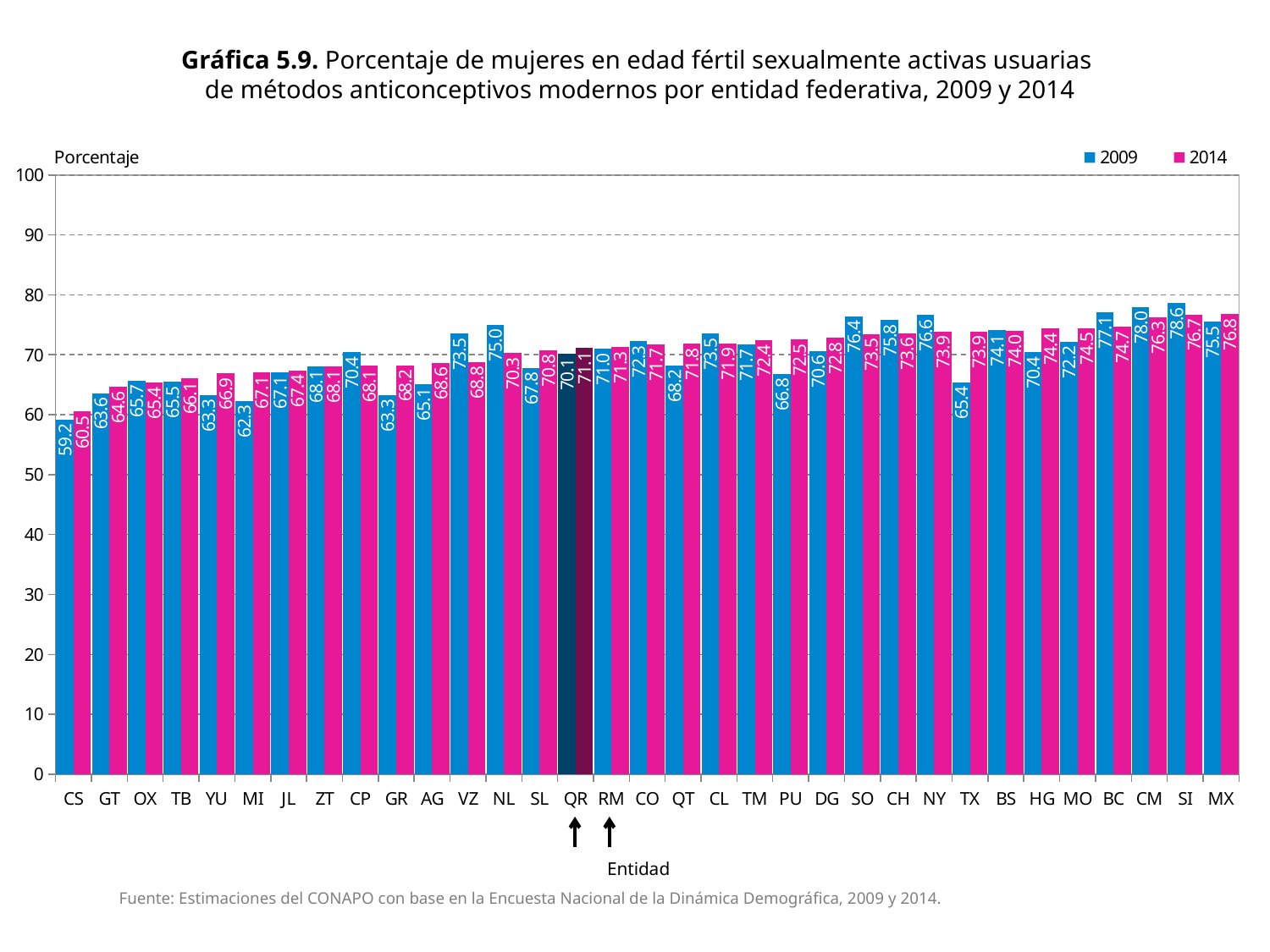
How many entities are shown on the x axis? 33 What kind of chart is this? Bar chart Which is larger for SO, the 2009 value or the 2014 value? 2009 What is the difference between the 2014 and 2009 values for TX? 8.5 What is the 2014 value for CS? 60.5 Which entity has the highest 2014 value? MX What is the 2014 value for RM? 71.3 Which entity has the highest 2009 value? SI What is the 2009 value for NL? 75.0 Do the 2014 values generally rise or fall from left to right along the x axis? Rise Which entity has the lowest 2009 value? CS How many series does the legend list? 2